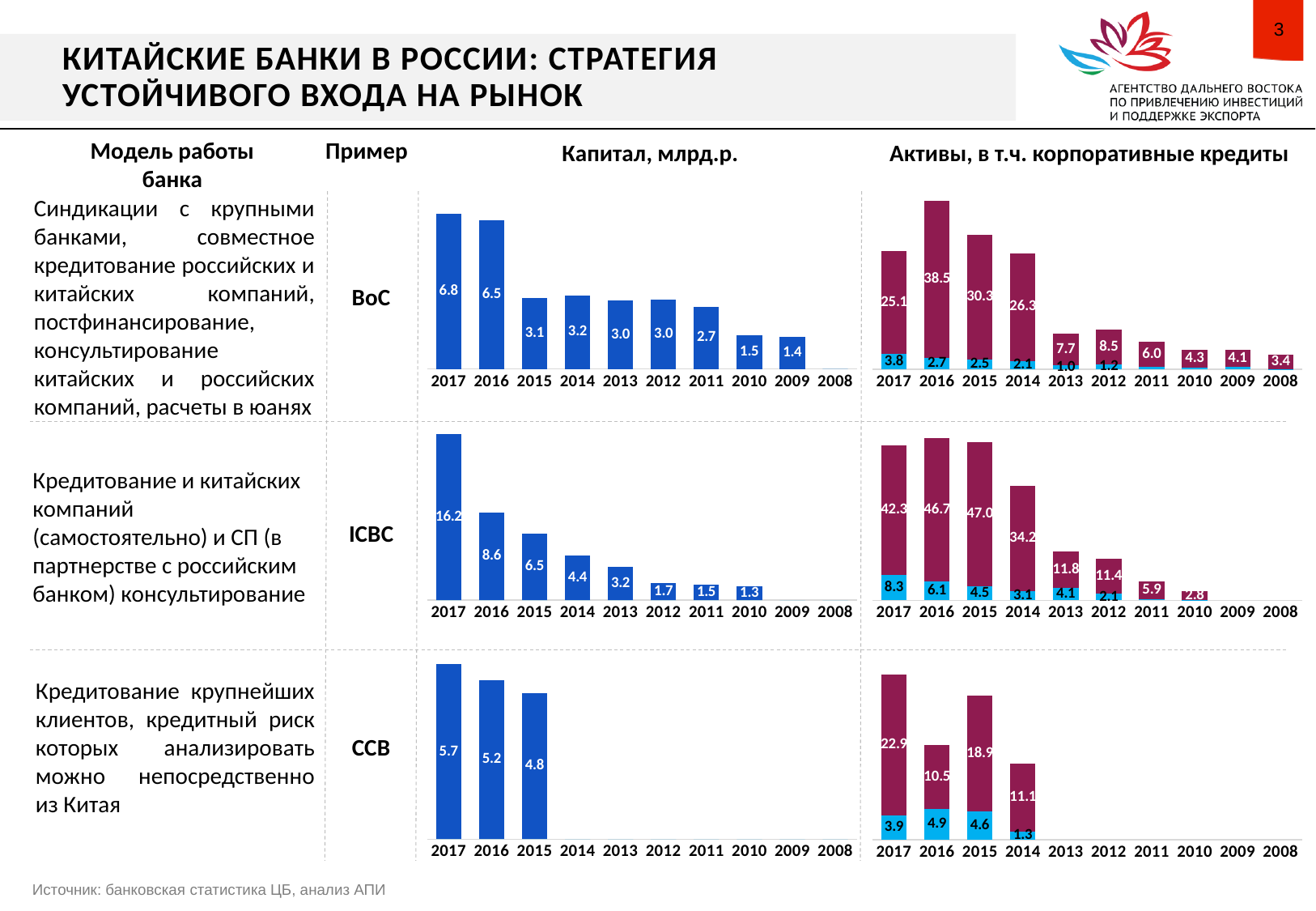
In the BoC assets chart (Активы), which year has the highest value? 2016 In the CCB assets chart, what is the value labelled on the small blue segment for 2016? 4.9 In the ICBC assets chart, is the value for 2014 larger or smaller than the value for 2013? larger In the BoC capital chart (Капитал, млрд.р.), what is the value for 2017? 6.8 In the ICBC capital chart, do the values rise or fall from 2017 to 2010? fall In the BoC assets chart, what is the value labelled on the large bar for 2015? 30.3 In the CCB capital chart, which year has the lowest value? 2015 How many years have bars in the CCB capital chart? 3 In the ICBC capital chart, which year has the highest value? 2017 In the BoC capital chart, what is the difference between the 2017 and 2016 values? 0.3 What type of chart is used for the ICBC capital data? bar chart In the ICBC capital chart, what is the value for 2016? 8.6